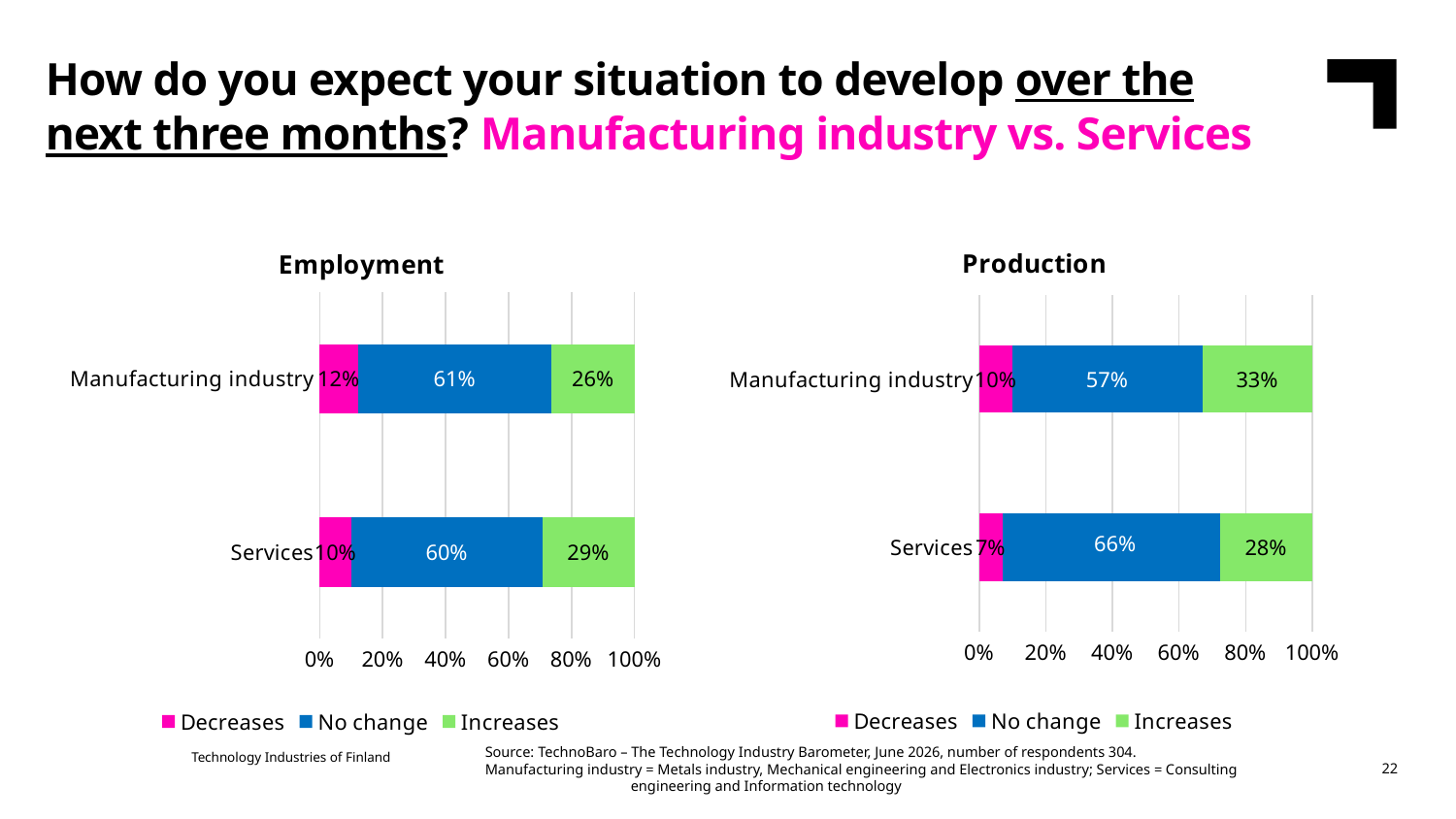
How many series does the legend of the Employment chart list? 3 What kind of chart is the Production chart? Stacked bar chart In the Employment chart, what percentage of the Manufacturing industry expects employment to increase? 26% In the Production chart, what is the total of the stacked bar for Services? 101% In the Employment chart, which category has the larger 'Increases' value, Manufacturing industry or Services? Services Which colour represents 'Decreases' in the Employment chart? Pink In the Production chart, what percentage of Services expects production to decrease? 7% In the Employment chart, what is the 'No change' value for Services? 60% In the Production chart, what is the difference between the 'No change' values for Services and the Manufacturing industry? 9% In the Production chart, what is the 'Increases' value for the Manufacturing industry? 33% In the Production chart, which category has the larger 'Decreases' value, Manufacturing industry or Services? Manufacturing industry In the Employment chart, what is the total of the stacked bar for the Manufacturing industry? 99%